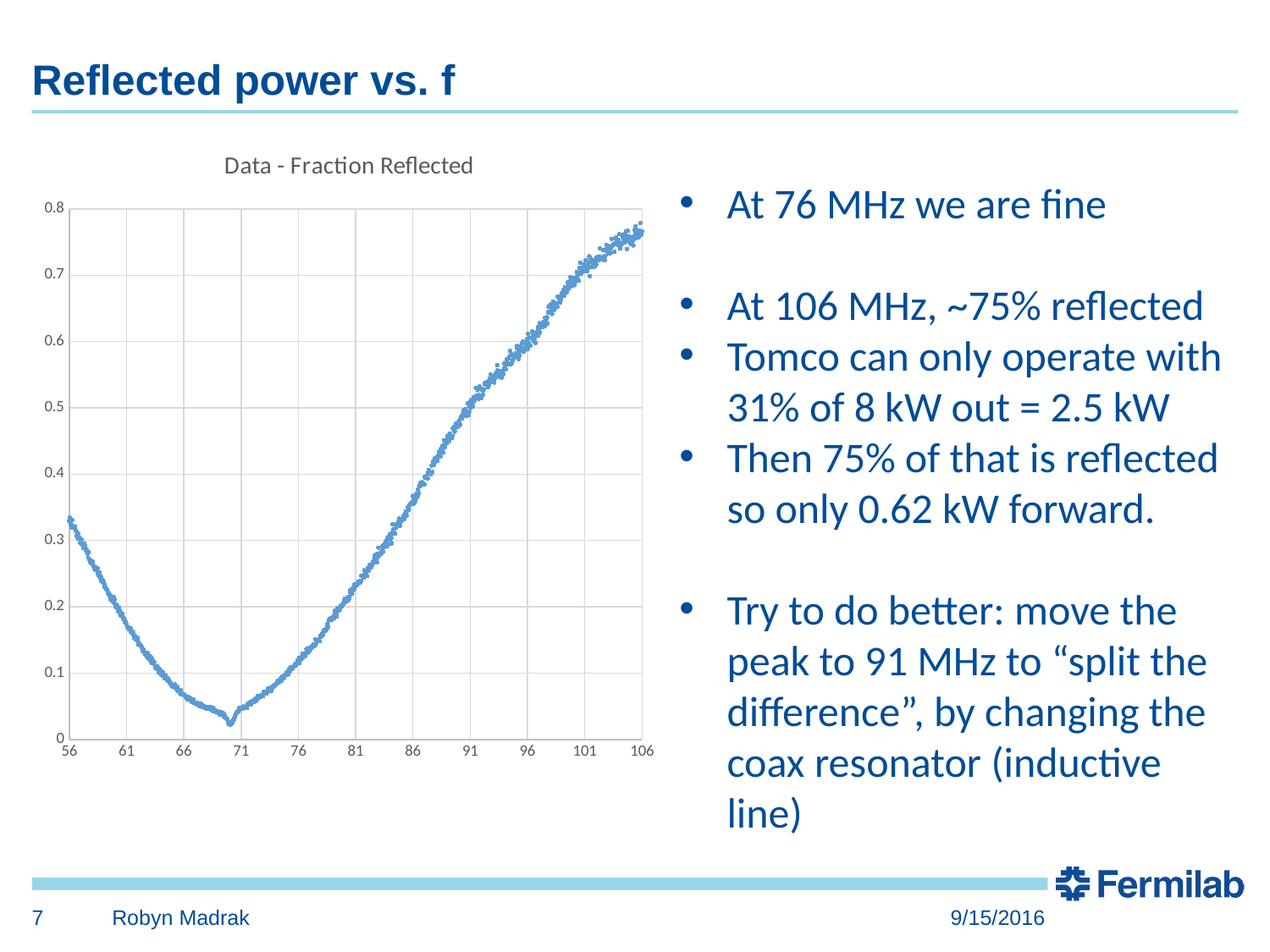
Is the fraction reflected at 56 greater or less than 0.3? greater What is the highest value shown on the chart's y axis? 0.8 Is the fraction reflected at 86 greater or less than 0.4? less Do the values rise or fall along the x axis from 56 to 66? fall Is the fraction reflected at 96 greater or less than 0.6? greater Which has the larger fraction reflected, 56 or 106? 106 What kind of chart is shown on the slide? scatter chart Do the values rise or fall along the x axis from 71 to 106? rise What is the title of the chart? Data - Fraction Reflected